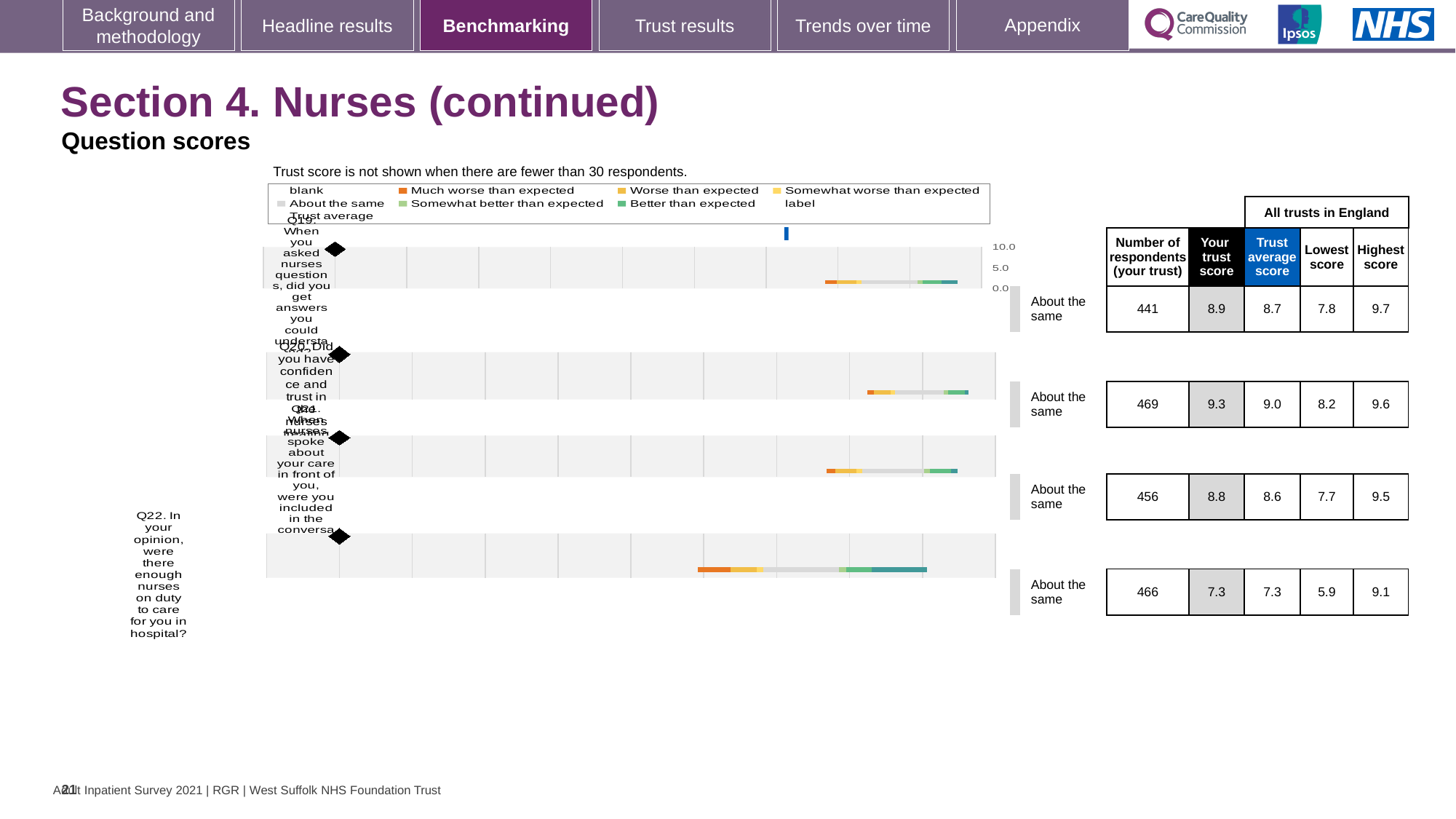
How many questions are plotted on the chart? 4 What is the lowest score across all trusts in England for Q22? 5.9 What kind of chart is used to show the question scores? Bar chart What is the trust average score for Q19 (did you get answers you could understand)? 8.7 What is the highest score across all trusts in England for Q21 (were you included in the conversation)? 9.5 What is the difference between your trust score and the trust average score for Q19? 0.2 Which question has the lowest 'Your trust score'? Q22 How many respondents from your trust answered Q20 (confidence and trust in the nurses)? 469 For Q21, which is larger: your trust score or the trust average score? Your trust score What is the 'Your trust score' for Q22 (were there enough nurses on duty to care for you in hospital)? 7.3 Which question has the highest 'Your trust score'? Q20 What benchmark category is shown for all four questions? About the same